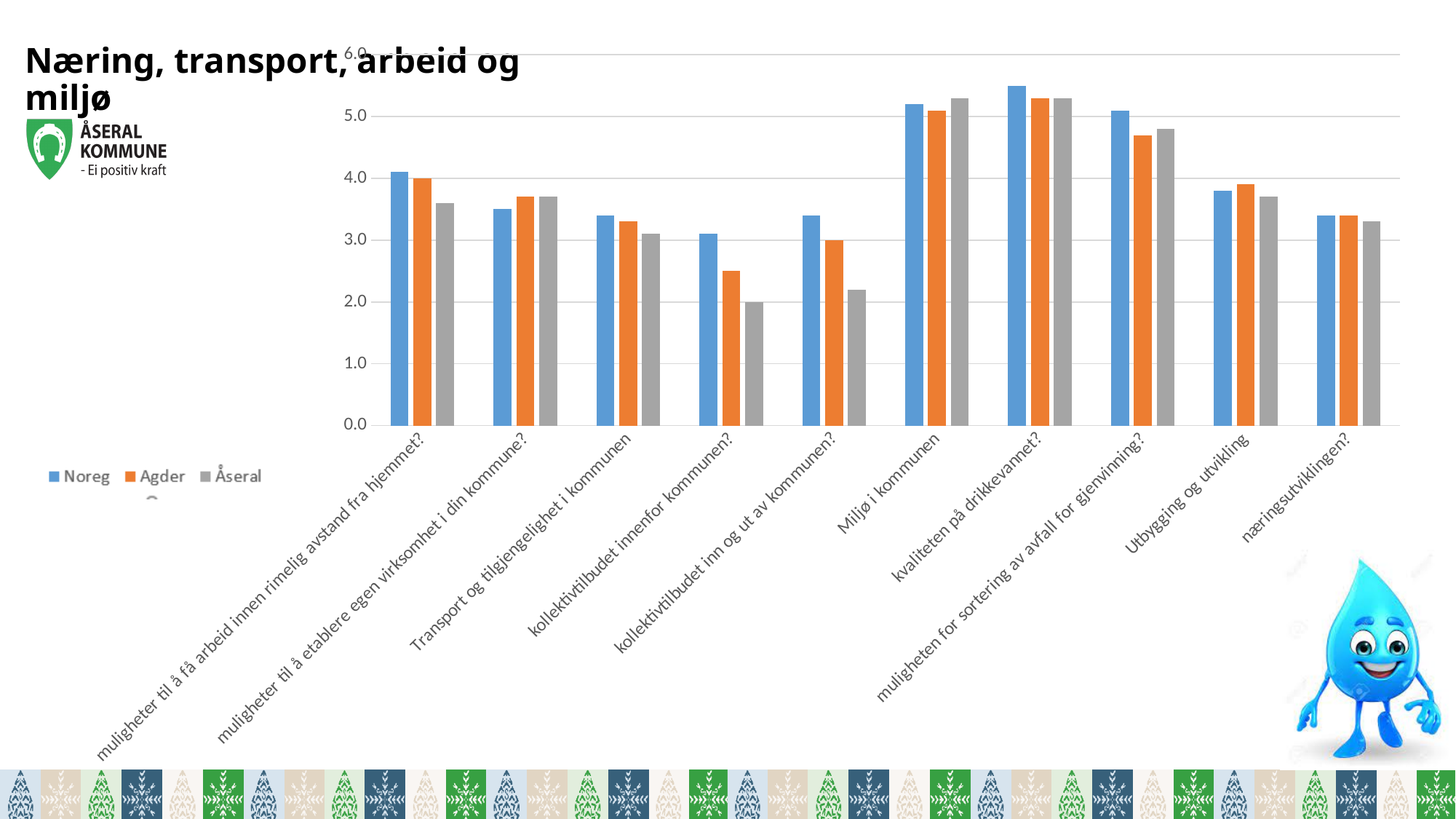
What kind of chart is shown on the slide? bar chart In the category "kollektivtilbudet innenfor kommunen?", which is larger, the Noreg value or the Åseral value? Noreg How many series does the legend list? 3 Which series is shown in orange in the legend? Agder What is the value for Åseral in the category "kollektivtilbudet innenfor kommunen?"? 2.0 Which category has the highest Noreg bar? kvaliteten på drikkevannet? Is the value for Agder in "kollektivtilbudet innenfor kommunen?" greater or less than 3.0? less Is the value for Åseral in "muligheten for sortering av avfall for gjenvinning?" greater or less than 4.0? greater What is the value for Agder in the category "kollektivtilbudet inn og ut av kommunen?"? 3.0 In the category "muligheter til å etablere egen virksomhet i din kommune?", which is larger, the Noreg value or the Agder value? Agder How many categories are shown along the x axis? 10 Which category has the lowest Åseral bar? kollektivtilbudet innenfor kommunen?